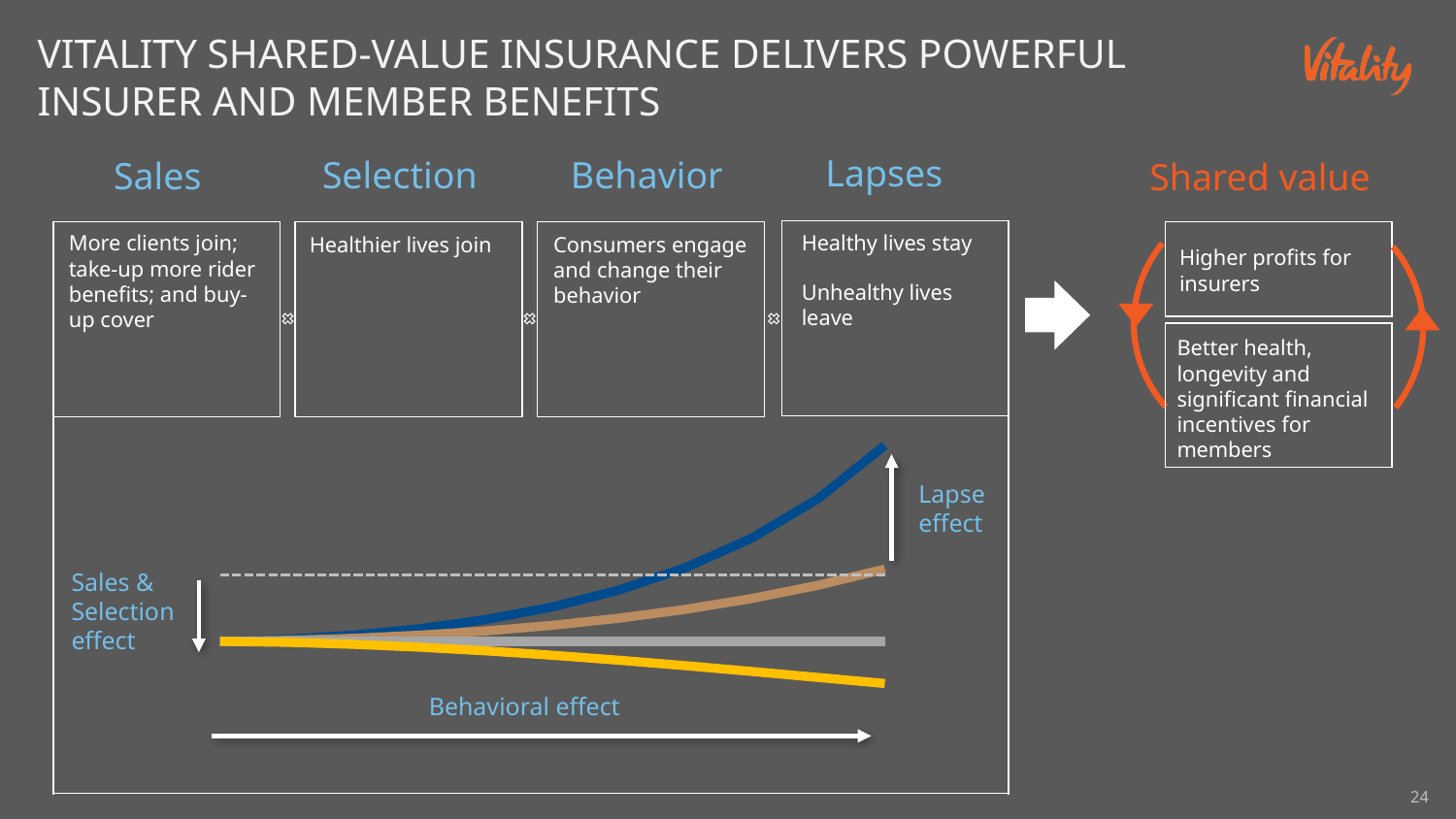
Which coloured line ends lowest at the right side of the chart? yellow Does the yellow line rise or fall from left to right? fall Does the dark blue line rise or fall from left to right? rise How many solid coloured lines are plotted in the chart? 4 At the right end of the chart, is the dark blue line above or below the dashed line? above What label appears next to the vertical arrow on the right side of the chart? Lapse effect What kind of chart is shown in the lower-left panel of the slide? line chart What label is written above the horizontal arrow at the bottom of the chart? Behavioral effect Does the solid gray line rise, fall, or stay flat from left to right? stay flat At the right end of the chart, is the tan line above or below the solid gray line? above Which coloured line ends highest at the right side of the chart? dark blue